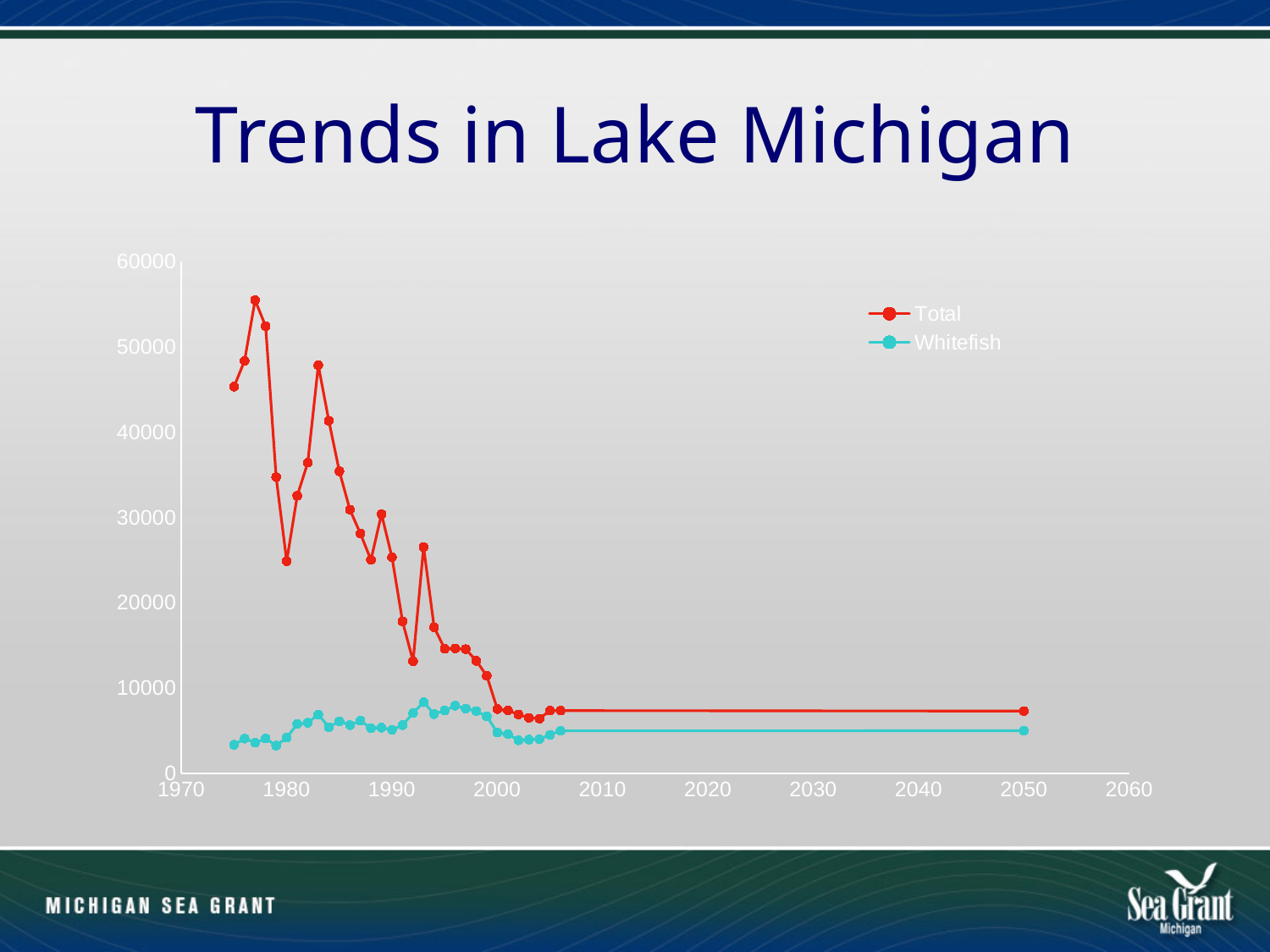
What kind of chart is shown on the slide? line chart What are the two series named in the legend? Total and Whitefish Is the value for Total in 1977 greater or less than 50000? greater Which is larger for the Total series, the value in 1977 or the value in 1983? 1977 Which series has the larger value in 1990, Total or Whitefish? Total How many series does the legend list? 2 In which year does the Total series reach its highest value? 1977 Is the value for Total in 1980 greater or less than 30000? less What is the title of the chart? Trends in Lake Michigan Does the Total series generally rise or fall between 1975 and 2000? fall Is the value for Total in 2050 greater or less than 10000? less